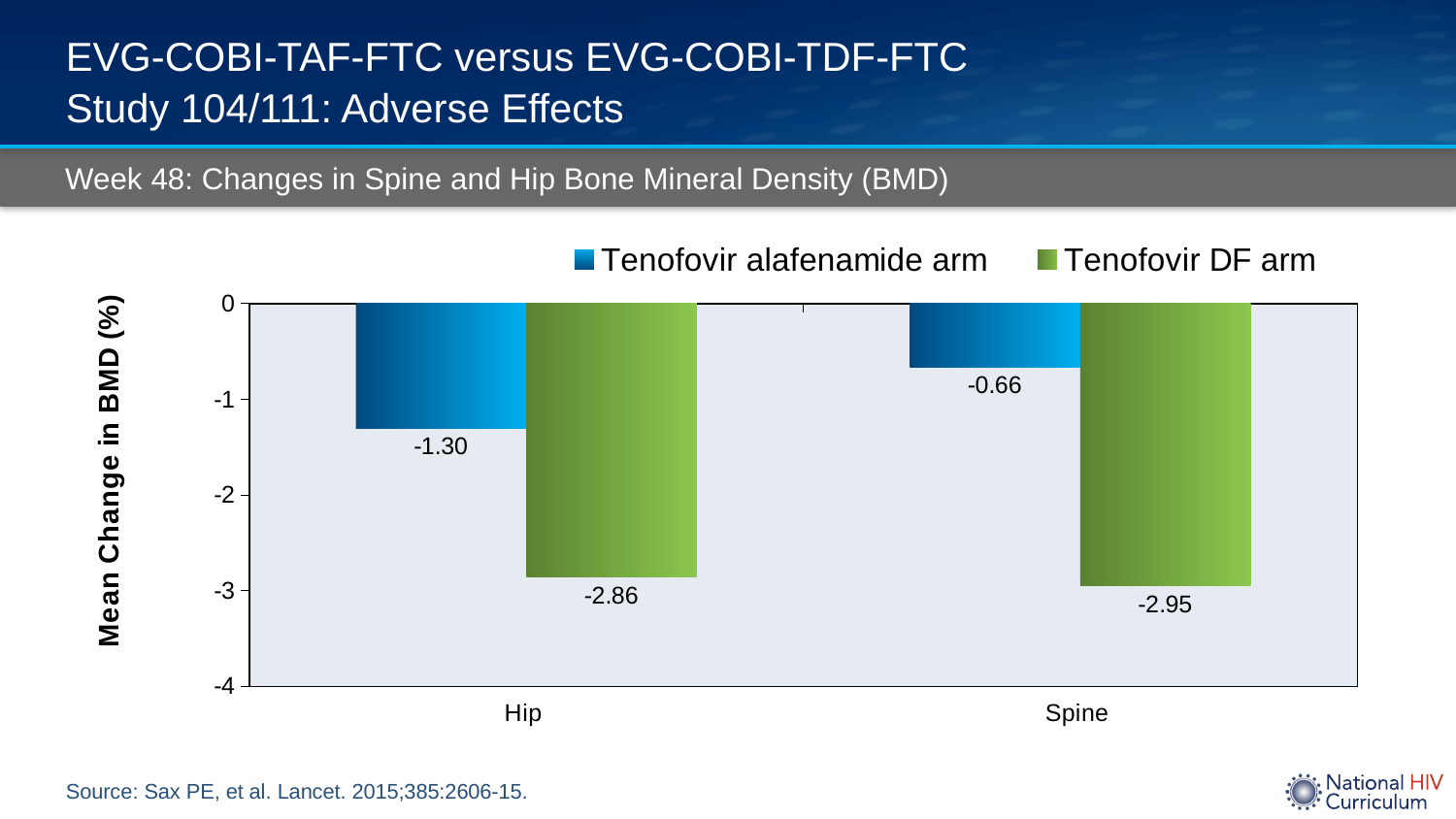
What is the mean change in BMD for the Tenofovir DF arm at the Spine? -2.95 How many categories are shown on the x axis? 2 What kind of chart is shown on the slide? Bar chart Which bar shows the smallest decrease in BMD? Tenofovir alafenamide arm, Spine What is the difference between the Tenofovir DF arm and the Tenofovir alafenamide arm at the Hip? 1.56 What is the difference between the Tenofovir DF arm and the Tenofovir alafenamide arm at the Spine? 2.29 What is the mean change in BMD for the Tenofovir alafenamide arm at the Spine? -0.66 How many series does the legend list? 2 Which arm shows a larger decrease in BMD at the Spine? Tenofovir DF arm What is the mean change in BMD for the Tenofovir DF arm at the Hip? -2.86 Which bar shows the lowest (most negative) mean change in BMD? Tenofovir DF arm, Spine What is the mean change in BMD for the Tenofovir alafenamide arm at the Hip? -1.30